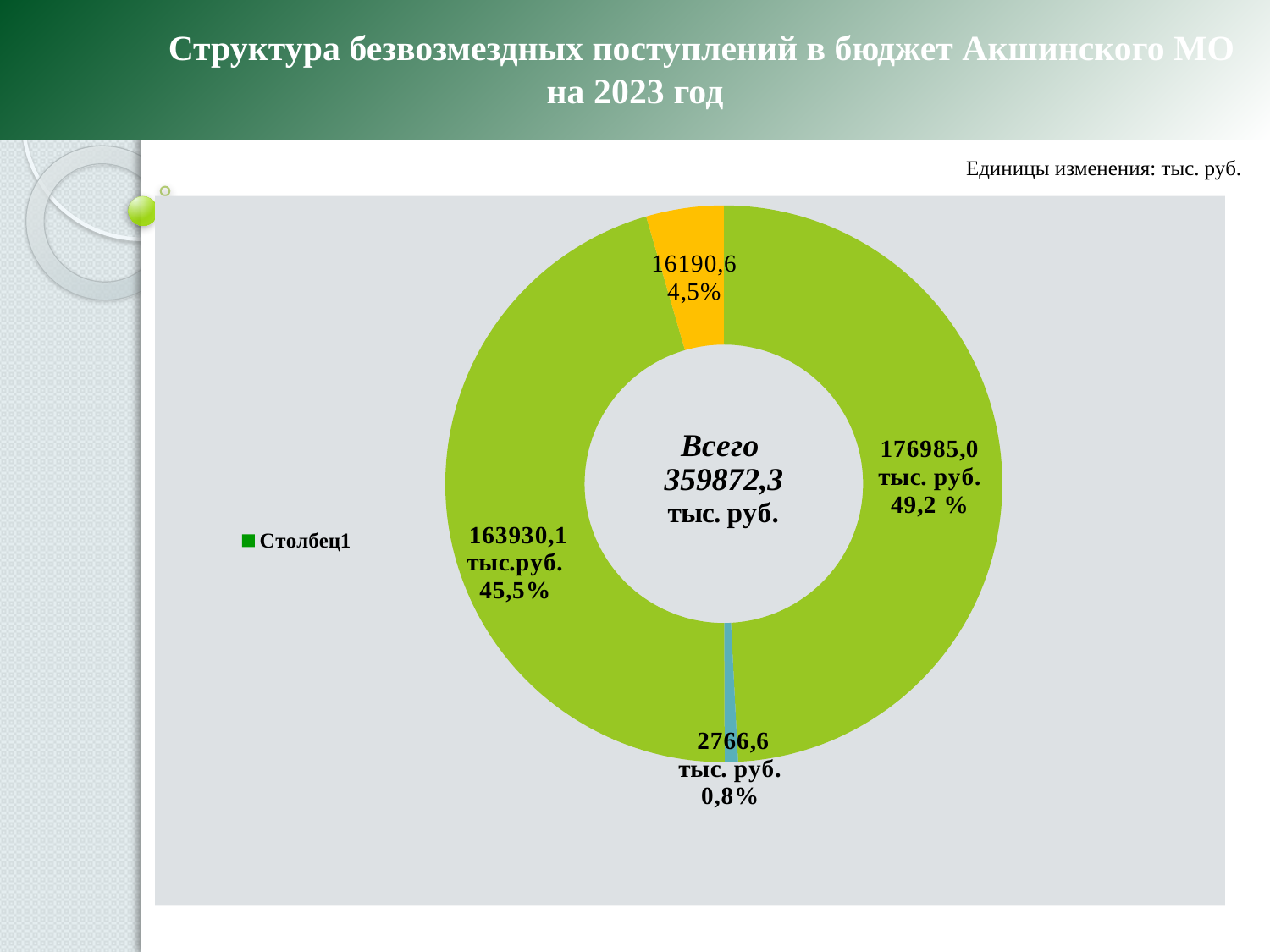
What share of the total does the yellow slice represent? 4,5% What is the share of the largest slice in the chart? 49,2 % What share of the total does the smallest slice represent? 0,8% Which slice is larger: the one with 49,2 % or the one with 45,5%? the one with 49,2 % (176985,0 тыс. руб.) How many slices does the doughnut chart have? 4 What total value is printed in the centre of the doughnut chart? 359872,3 тыс. руб. What value is printed on the smallest (blue) slice of the chart? 2766,6 тыс. руб. What is the difference between the two largest slices, 176985,0 and 163930,1 тыс. руб.? 13054,9 тыс. руб. What entry is listed in the chart legend? Столбец1 What kind of chart is shown on the slide? doughnut (pie) chart What units of measurement are stated above the chart? тыс. руб. What value is printed on the yellow slice of the chart? 16190,6